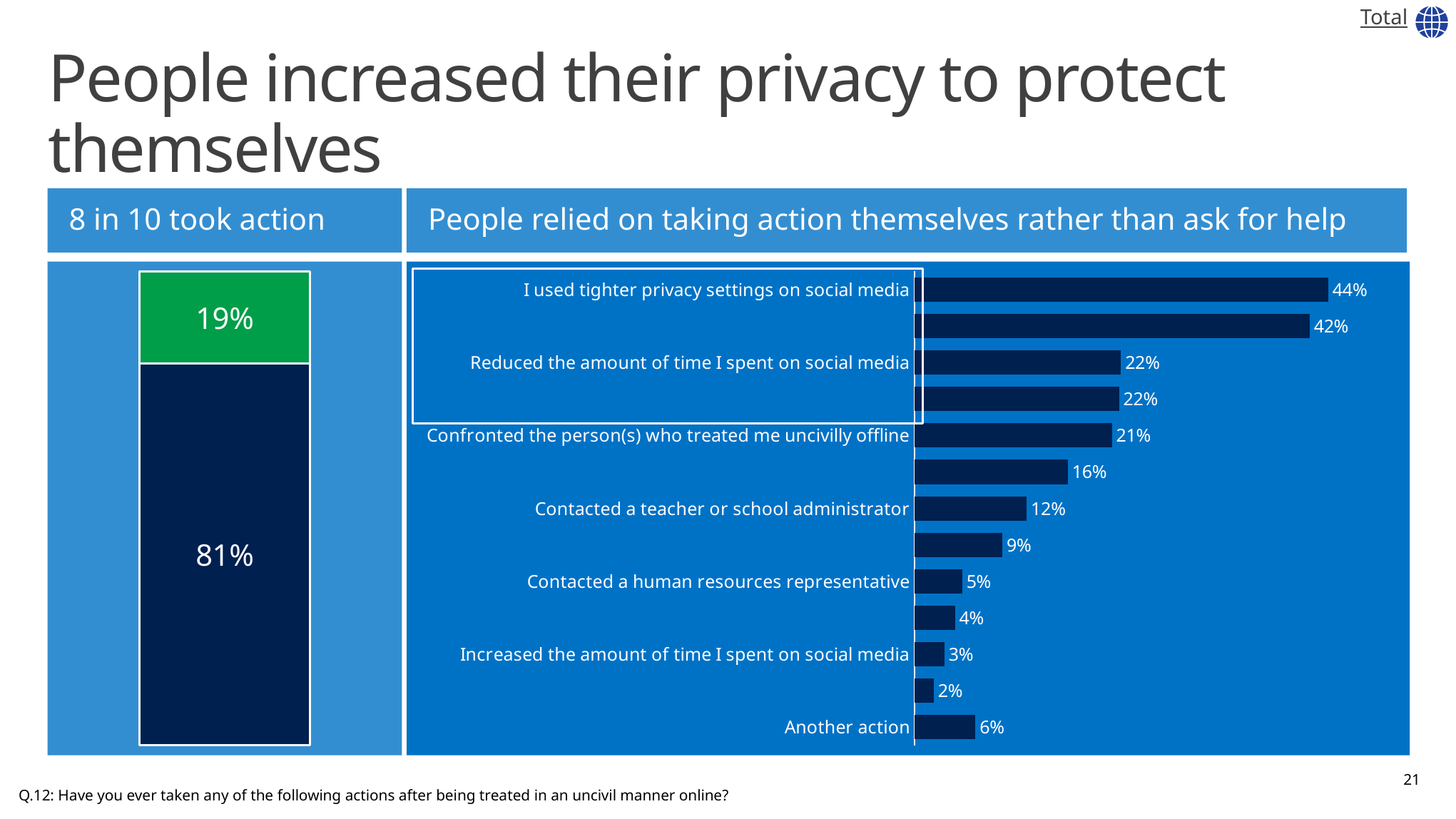
In the right-hand chart, what is the value for 'Another action'? 6% How many bars are plotted in the right-hand chart? 13 In the left-hand chart titled '8 in 10 took action', what value is shown in the green segment? 19% In the right-hand chart, what is the value for 'Contacted a teacher or school administrator'? 12% In the right-hand chart, which labelled action has the highest value? I used tighter privacy settings on social media In the right-hand chart, what percentage of people used tighter privacy settings on social media? 44% In the left-hand chart titled '8 in 10 took action', what value is shown in the dark blue segment? 81% In the right-hand chart, what is the difference between 'Confronted the person(s) who treated me uncivilly offline' and 'Increased the amount of time I spent on social media'? 18% What kind of chart is shown on the right-hand side of the slide? Bar chart In the right-hand chart, which is larger: 'Contacted a human resources representative' or 'Another action'? Another action In the right-hand chart, what is the value for 'Reduced the amount of time I spent on social media'? 22% In the right-hand chart, what is the difference between 'I used tighter privacy settings on social media' and 'Reduced the amount of time I spent on social media'? 22%